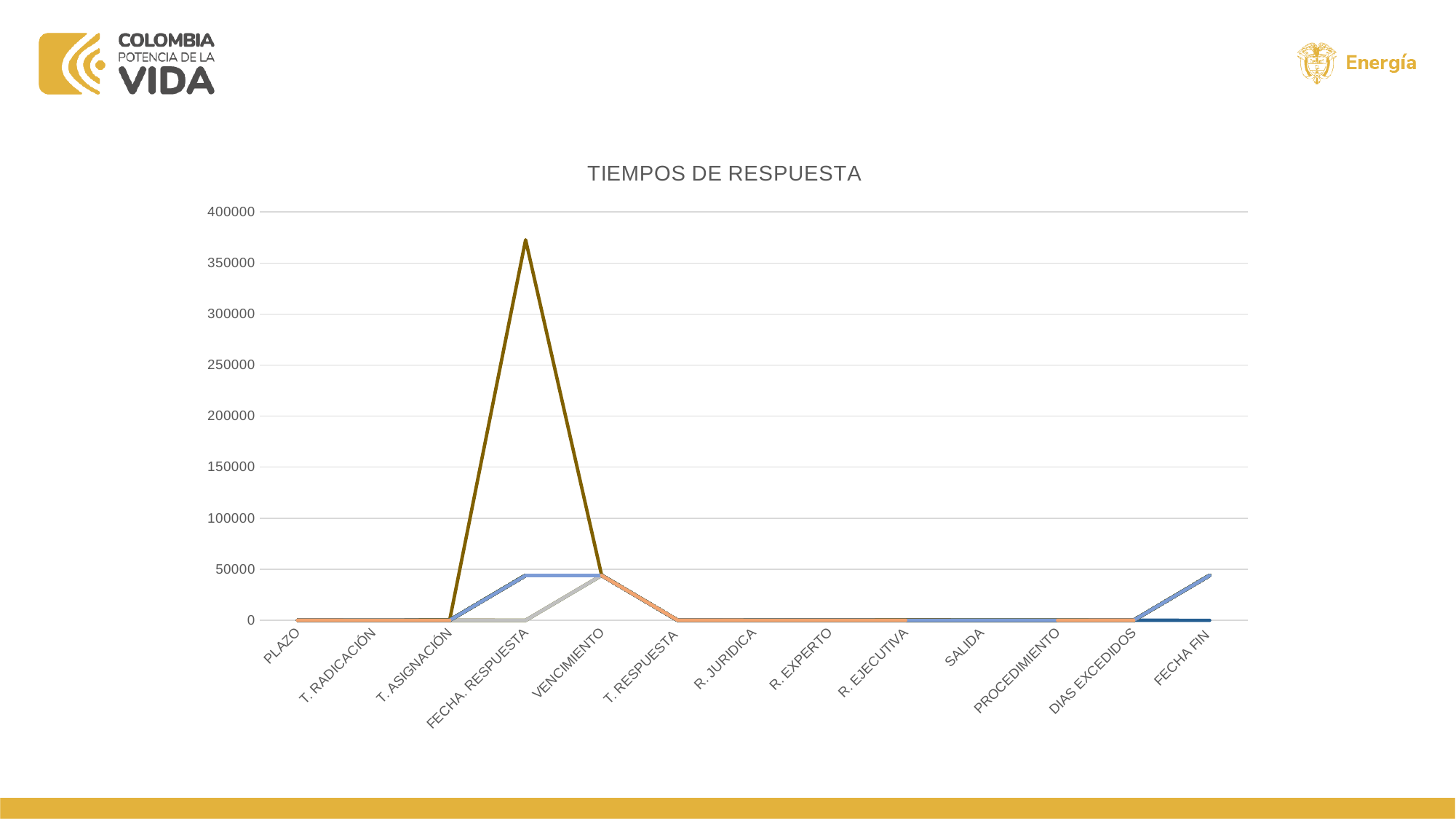
Do the values rise or fall between FECHA. RESPUESTA and T. RESPUESTA? fall At which category does the chart reach its highest value? FECHA. RESPUESTA Is the peak value at FECHA. RESPUESTA greater or less than 350000? greater Is the highest value at VENCIMIENTO greater or less than 100000? less What is the title of the chart? TIEMPOS DE RESPUESTA What is the first category on the x axis? PLAZO What is the last category on the x axis? FECHA FIN How many categories are shown along the x axis of the chart? 13 Is the highest value at FECHA FIN greater or less than 50000? less What is the highest value shown on the y axis? 400000 Which category has the larger peak value, FECHA. RESPUESTA or VENCIMIENTO? FECHA. RESPUESTA What kind of chart is shown on the slide? Line chart